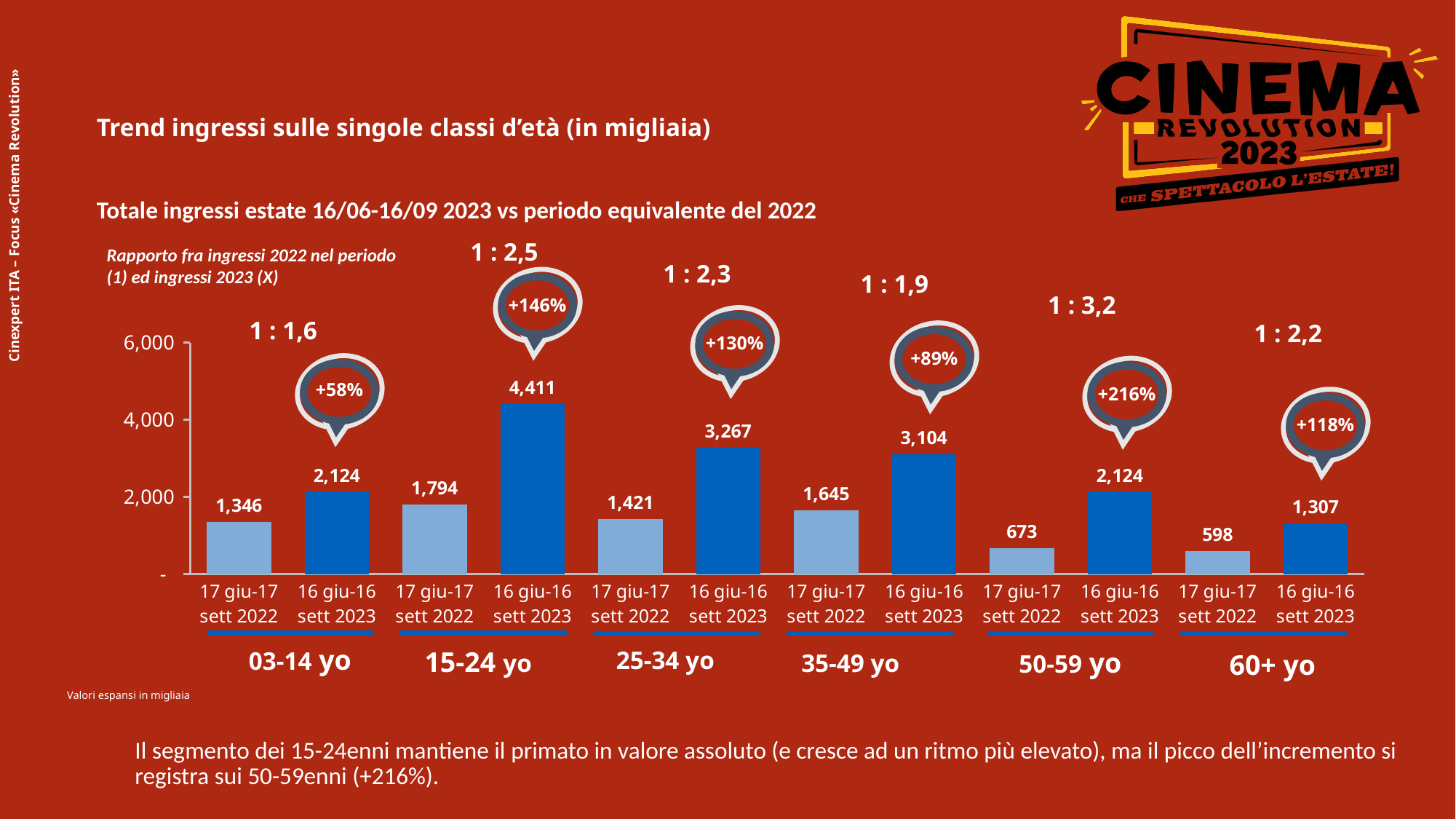
Which is larger: the 2023 value for 35-49 yo or the 2023 value for 25-34 yo? 25-34 yo What is the difference between the 2023 and 2022 values for the 25-34 yo age group? 1,846 How many age groups are shown on the chart? 6 What is the value for the 50-59 yo age group in the 17 giu-17 sett 2022 period? 673 What is the value for the 15-24 yo age group in the 16 giu-16 sett 2023 period? 4,411 What is the value for the 60+ yo age group in the 16 giu-16 sett 2023 period? 1,307 What percentage increase is shown in the callout for the 50-59 yo age group? +216% What ratio is shown above the 15-24 yo age group? 1 : 2,5 Which age group has the lowest value in the 17 giu-17 sett 2022 period? 60+ yo What kind of chart is shown on the slide? bar chart Is the 2022 value for the 03-14 yo age group greater or less than 2,000? less Which age group has the highest value in the 16 giu-16 sett 2023 period? 15-24 yo